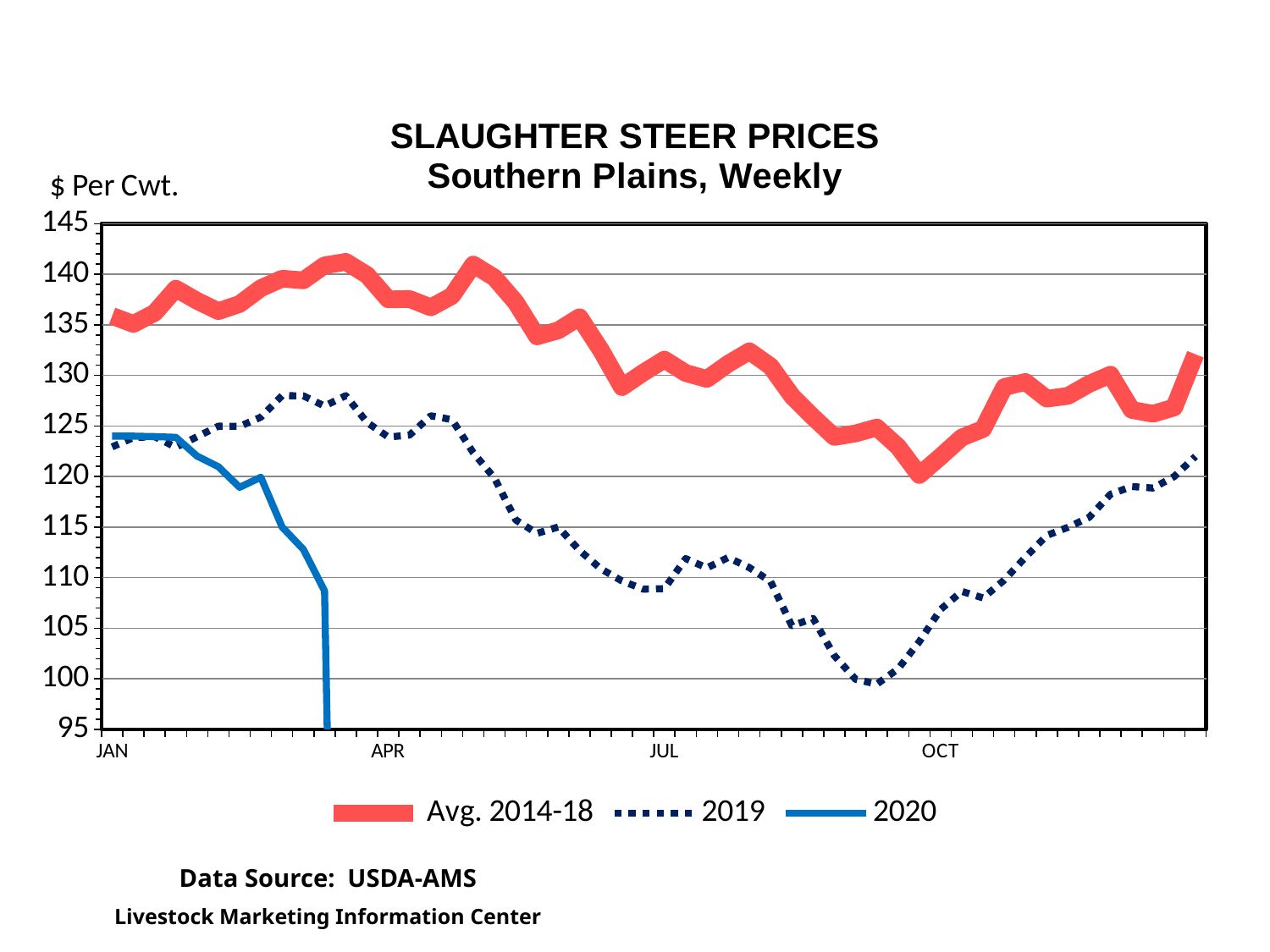
Which series stays highest across the whole year? Avg. 2014-18 What is the title of the chart? SLAUGHTER STEER PRICES Southern Plains, Weekly How many month labels are shown on the x axis? 4 Does the 2019 series rise or fall between JUL and OCT? fall Is the value of the 2019 series at OCT greater or less than 105? greater What unit is shown on the y axis label? $ Per Cwt. Is the value of the 2020 series at JAN greater or less than 130? less Is the value of the Avg. 2014-18 series at JAN greater or less than 130? greater At APR, which series has the higher value, Avg. 2014-18 or 2019? Avg. 2014-18 What kind of chart is shown on the slide? line chart How many series does the legend list? 3